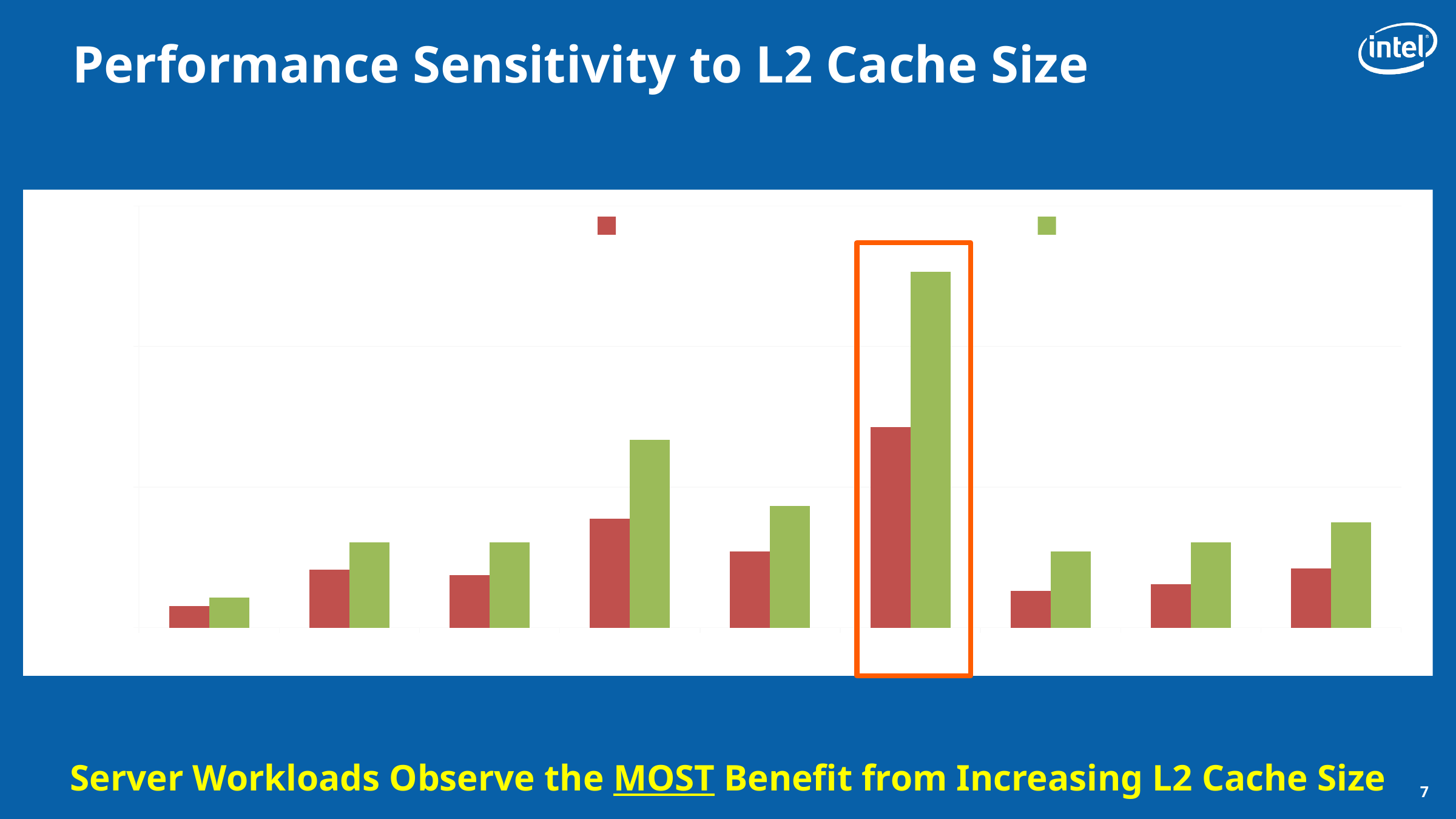
How many groups of bars are plotted in the chart? 9 What kind of chart is shown on the slide? bar chart How many series does the chart's legend show? 2 Which group of bars contains the tallest green bar in the chart? the group highlighted by the orange box (sixth from the left) What two colours are used for the bar series in the chart? red and green In the group of bars highlighted by the orange box, is the red bar or the green bar taller? green Which group of bars contains the tallest red bar in the chart? the group highlighted by the orange box (sixth from the left) In the first group of bars from the left, is the red bar or the green bar taller? green What is the title of the slide containing the chart? Performance Sensitivity to L2 Cache Size Which group of bars has the shortest red bar in the chart? the first group from the left